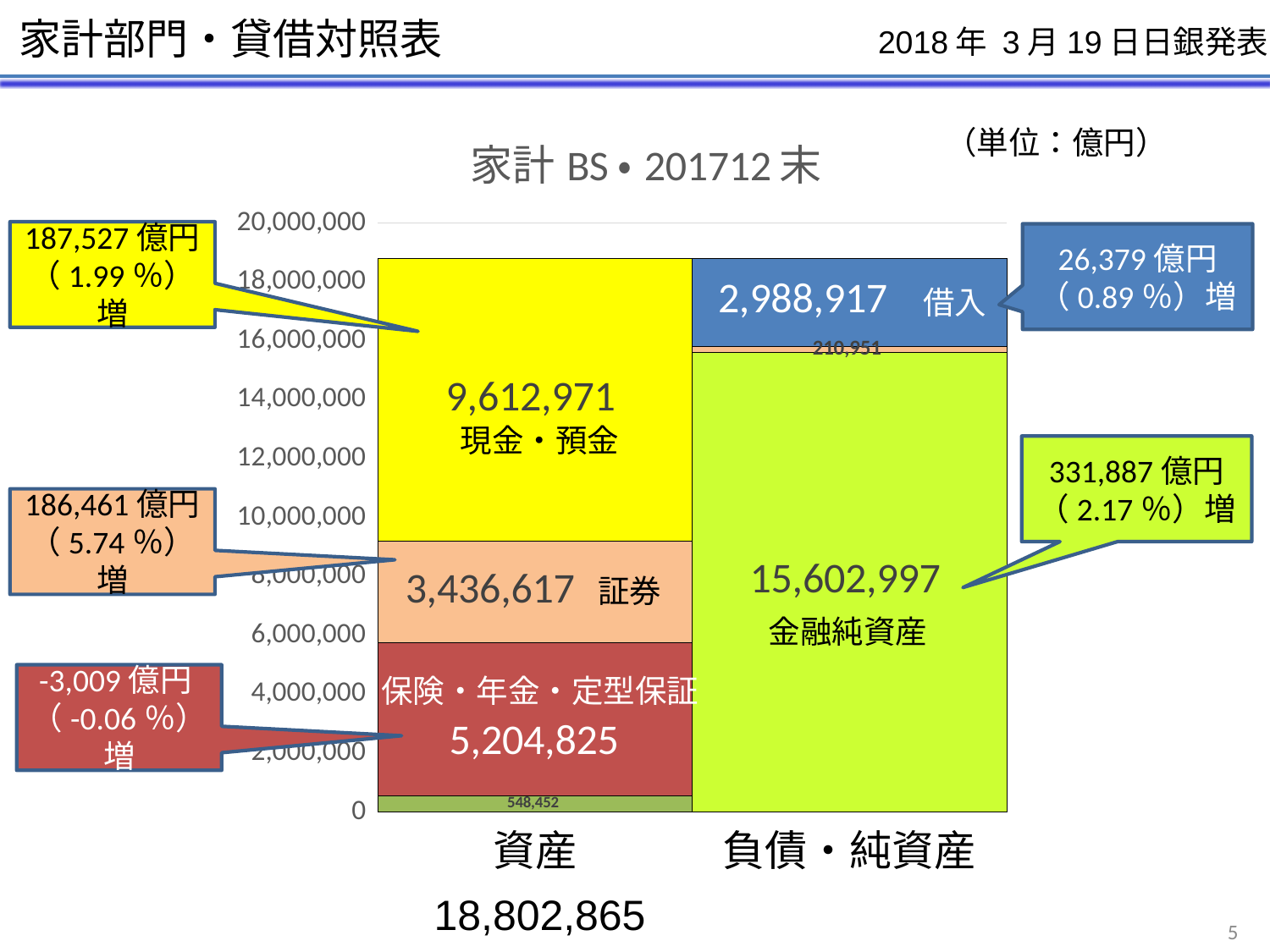
What type of chart is shown on the slide? stacked bar chart How many categories are shown on the x axis? 2 According to the callout, by how much did 金融純資産 increase? 331,887 億円（2.17%）増 What is the value of the 借入 segment in the 負債・純資産 bar? 2,988,917 What is the value of the 保険・年金・定型保証 segment? 5,204,825 What is the value of the 金融純資産 segment? 15,602,997 What is the difference between the 現金・預金 and 証券 values? 6,176,354 What is the total of the 資産 stacked bar? 18,802,865 What is the value of the 現金・預金 segment in the 資産 bar? 9,612,971 Which is larger, 現金・預金 or 証券? 現金・預金 Which labelled segment in the chart has the largest value? 金融純資産 What is the value of the 証券 segment in the 資産 bar? 3,436,617